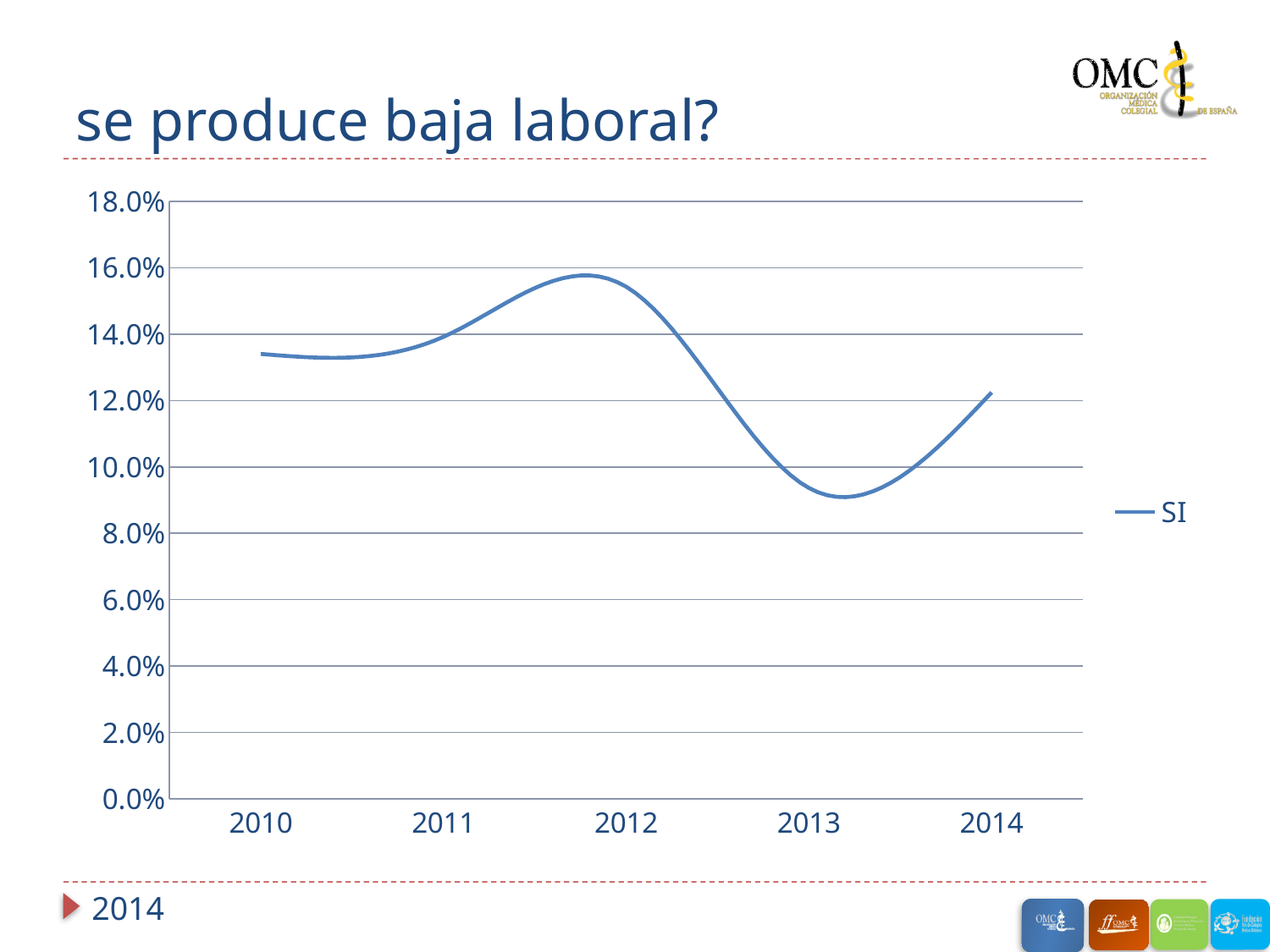
In which year is the value for SI lowest? 2013 In which year is the value for SI highest? 2012 How many years are shown on the x axis? 5 Is the value for SI in 2010 greater or less than 12.0%? greater Does the value for SI rise or fall from 2012 to 2013? fall Which year has the larger value for SI, 2012 or 2013? 2012 Is the value for SI in 2012 greater or less than 14.0%? greater How many series does the legend list? 1 Does the value for SI rise or fall from 2013 to 2014? rise What kind of chart is shown on the slide? line chart What is the name of the series shown in the legend? SI Is the value for SI in 2013 greater or less than 10.0%? less